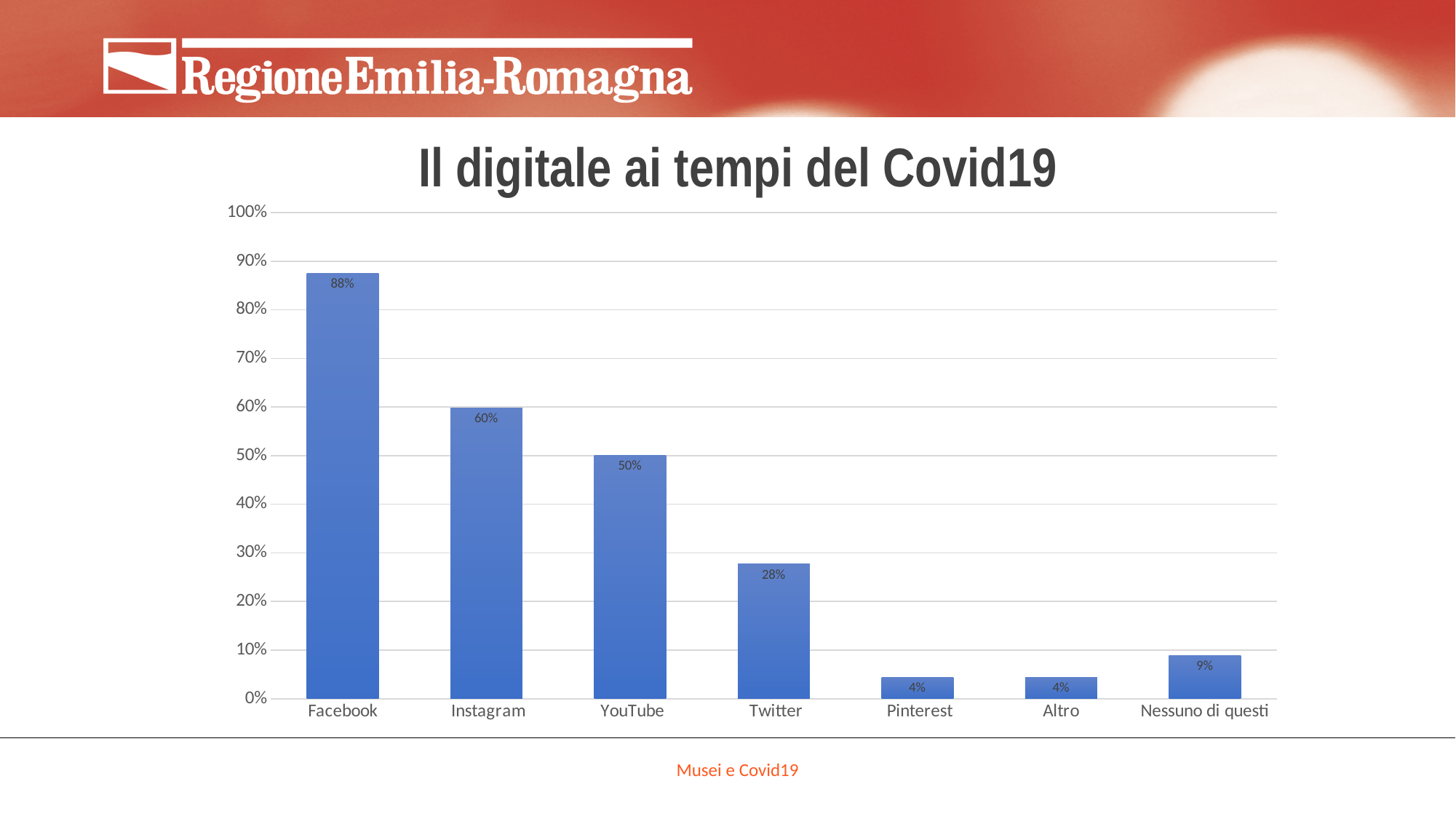
Which is larger, the value for Nessuno di questi or the value for Pinterest? Nessuno di questi What is the difference between the values for YouTube and Twitter? 22% What is the difference between the values for Facebook and Instagram? 28% How many categories are shown on the x axis? 7 What is the title of the chart? Il digitale ai tempi del Covid19 What is the value for Instagram? 60% What is the value for Nessuno di questi? 9% What is the value for Facebook? 88% What kind of chart is shown on the slide? Bar chart What is the value for Twitter? 28% Which category has the highest value? Facebook Is the value for YouTube greater or less than 40%? greater